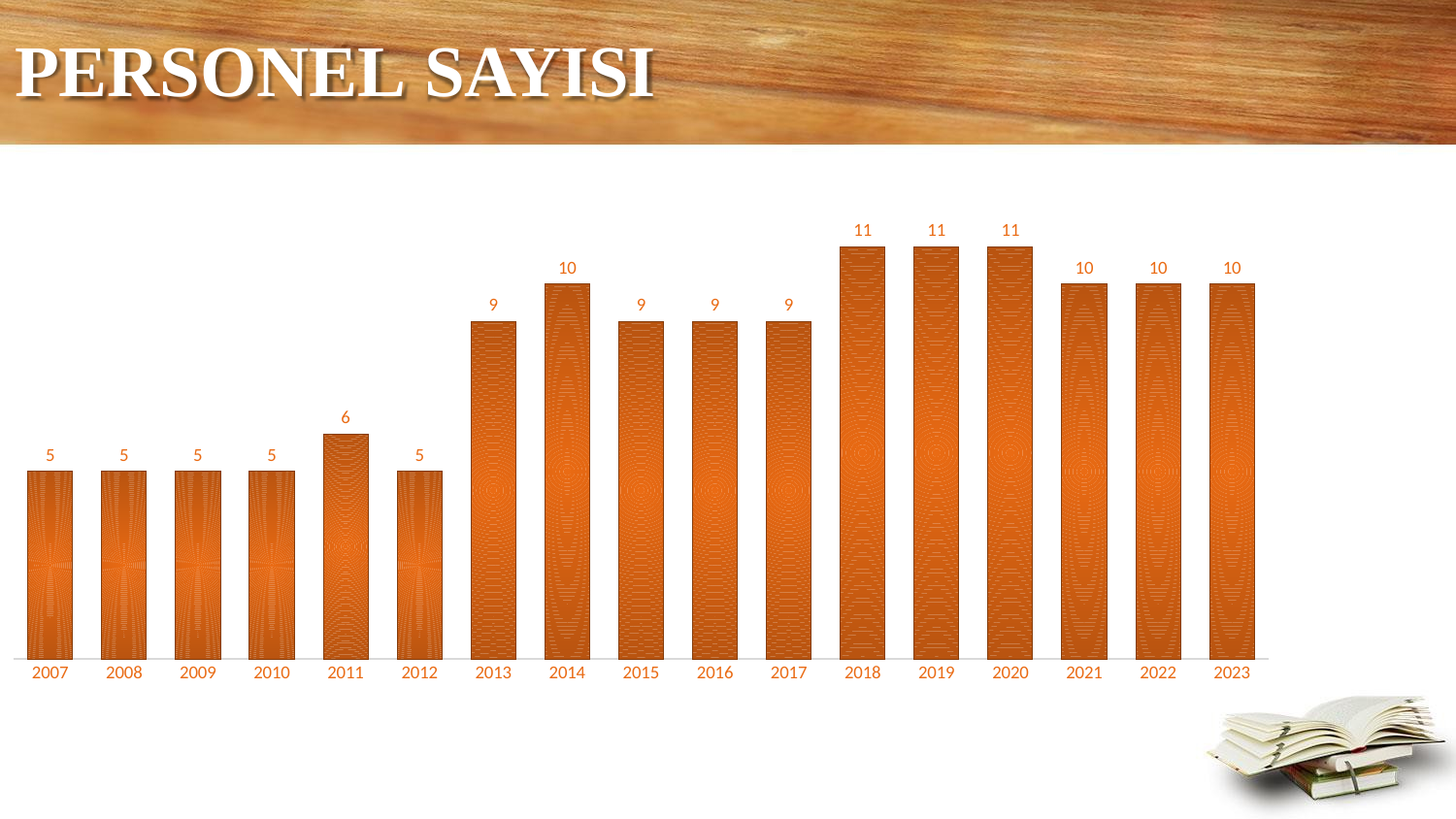
Which is larger, the value for 2011 or the value for 2012? 2011 What is the difference between the values for 2014 and 2013? 1 What is the value for 2011? 6 What is the difference between the values for 2018 and 2012? 6 How many years are shown on the x axis? 17 What is the title of the slide? PERSONEL SAYISI What kind of chart is shown on the slide? Bar chart Do the values generally rise or fall from 2007 to 2020? Rise What is the value for 2023? 10 What is the value for 2014? 10 Which years have the highest value? 2018, 2019, 2020 What is the lowest value shown in the chart? 5